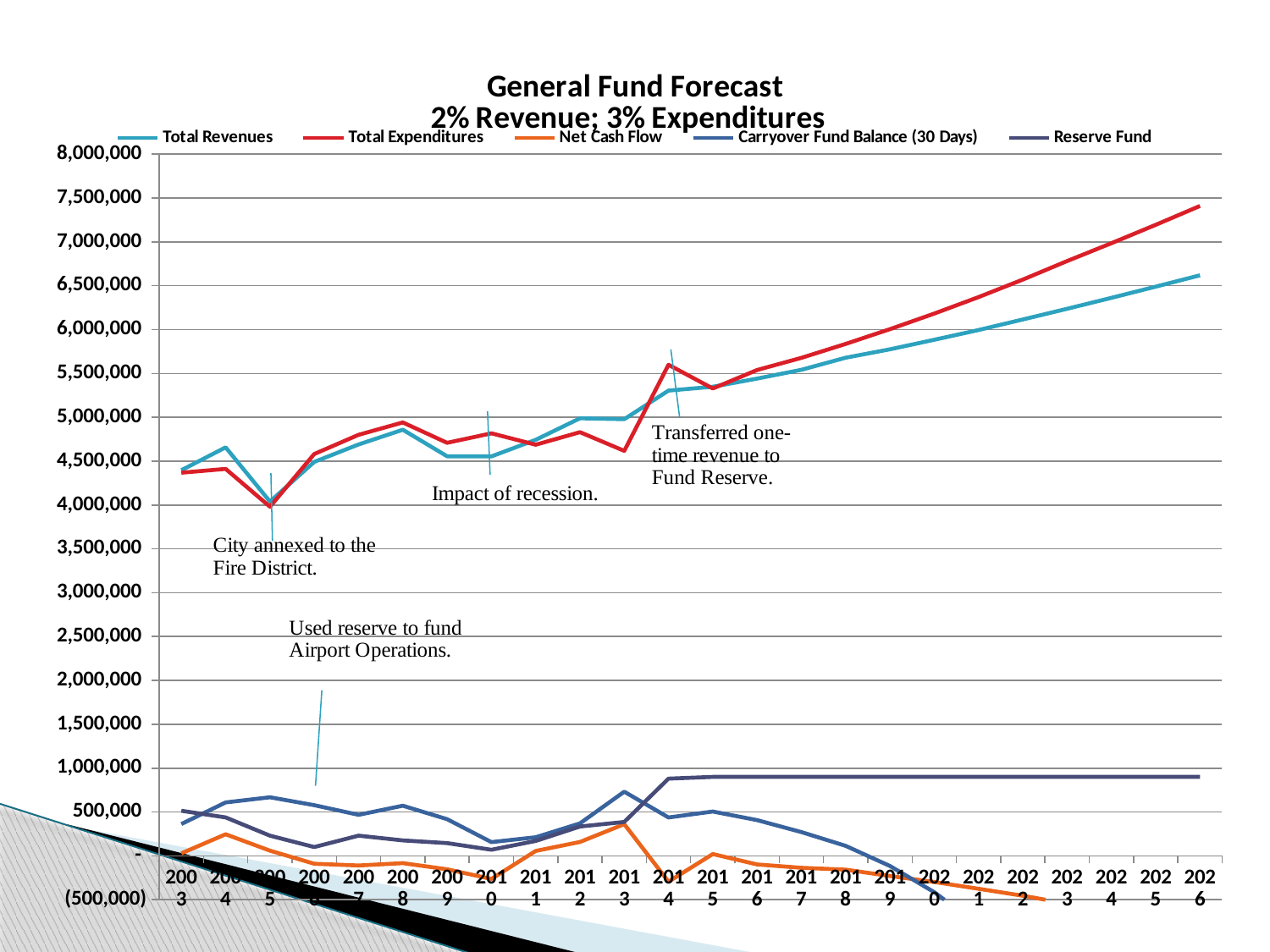
How many years are plotted along the x axis? 24 Is the value for Reserve Fund in 2020 greater or less than 500,000? greater Is the value for Total Revenues in 2005 greater or less than 4,500,000? less What is the title of the chart? General Fund Forecast 2% Revenue; 3% Expenditures In which year is Total Expenditures highest? 2026 In 2004, which is larger: Total Revenues or Total Expenditures? Total Revenues Which series is drawn in red? Total Expenditures In 2026, which is larger: Total Revenues or Total Expenditures? Total Expenditures How many series does the legend list? 5 Is the value for Total Expenditures in 2026 greater or less than 7,000,000? greater What kind of chart is shown on the slide? Line chart Does Total Expenditures rise or fall from 2014 to 2026? Rise